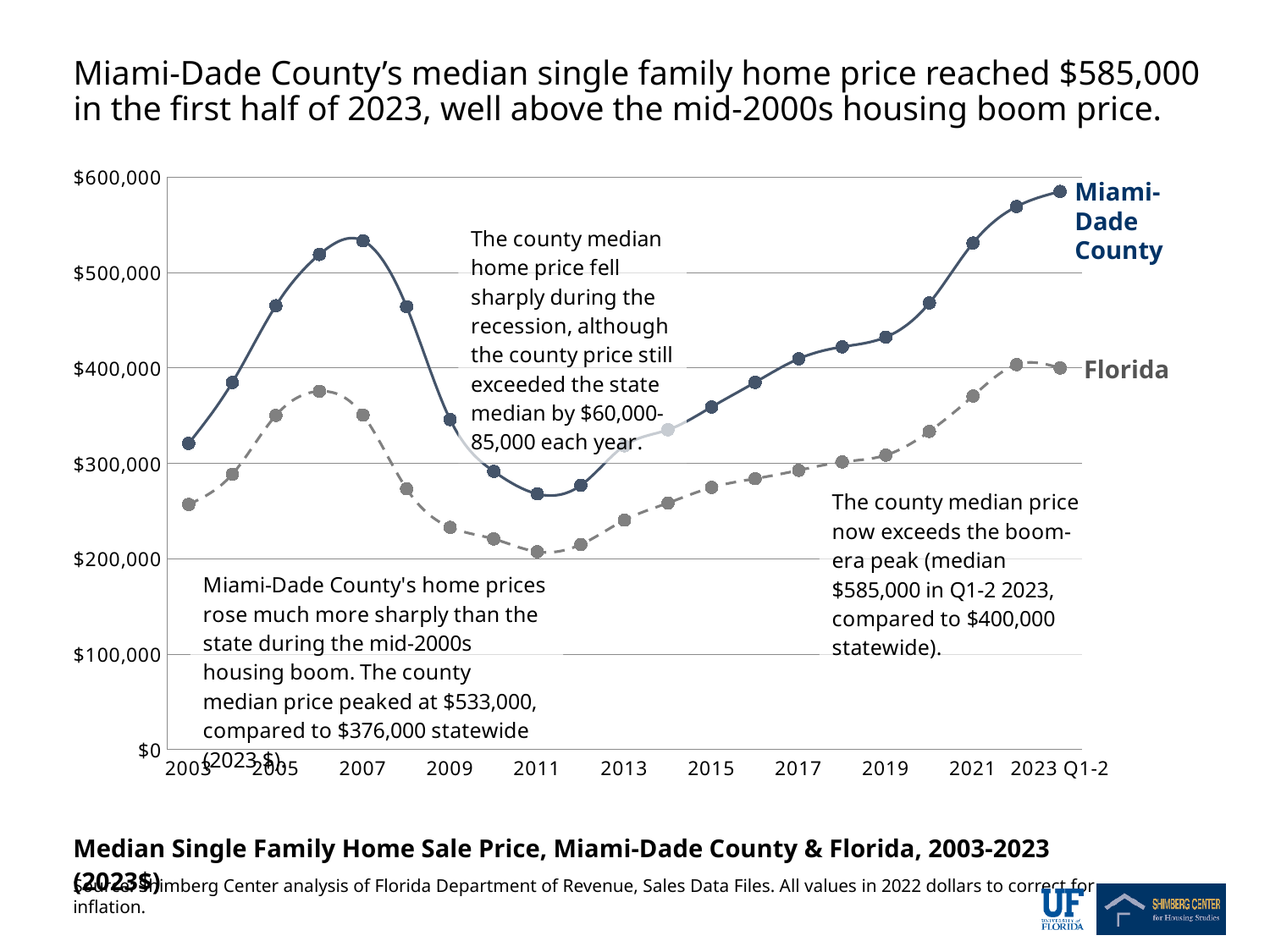
In 2007, which series has the larger value, Miami-Dade County or Florida? Miami-Dade County Does the Miami-Dade County series rise or fall between 2007 and 2011? fall According to the slide, what was the statewide median price in Q1-2 2023? $400,000 According to the slide, at what value did the Miami-Dade County median price peak during the mid-2000s housing boom? $533,000 Is the Florida value for 2007 greater or less than $400,000? less What kind of chart is shown on the slide? line chart According to the slide, what was Miami-Dade County's median single family home price in Q1-2 2023? $585,000 Is the Miami-Dade County value for 2011 greater or less than $300,000? less In which year does the Miami-Dade County series reach its highest value? 2023 Q1-2 How many series does the chart plot? 2 Which series is drawn with a dashed grey line? Florida Is the Miami-Dade County value for 2021 greater or less than $500,000? greater